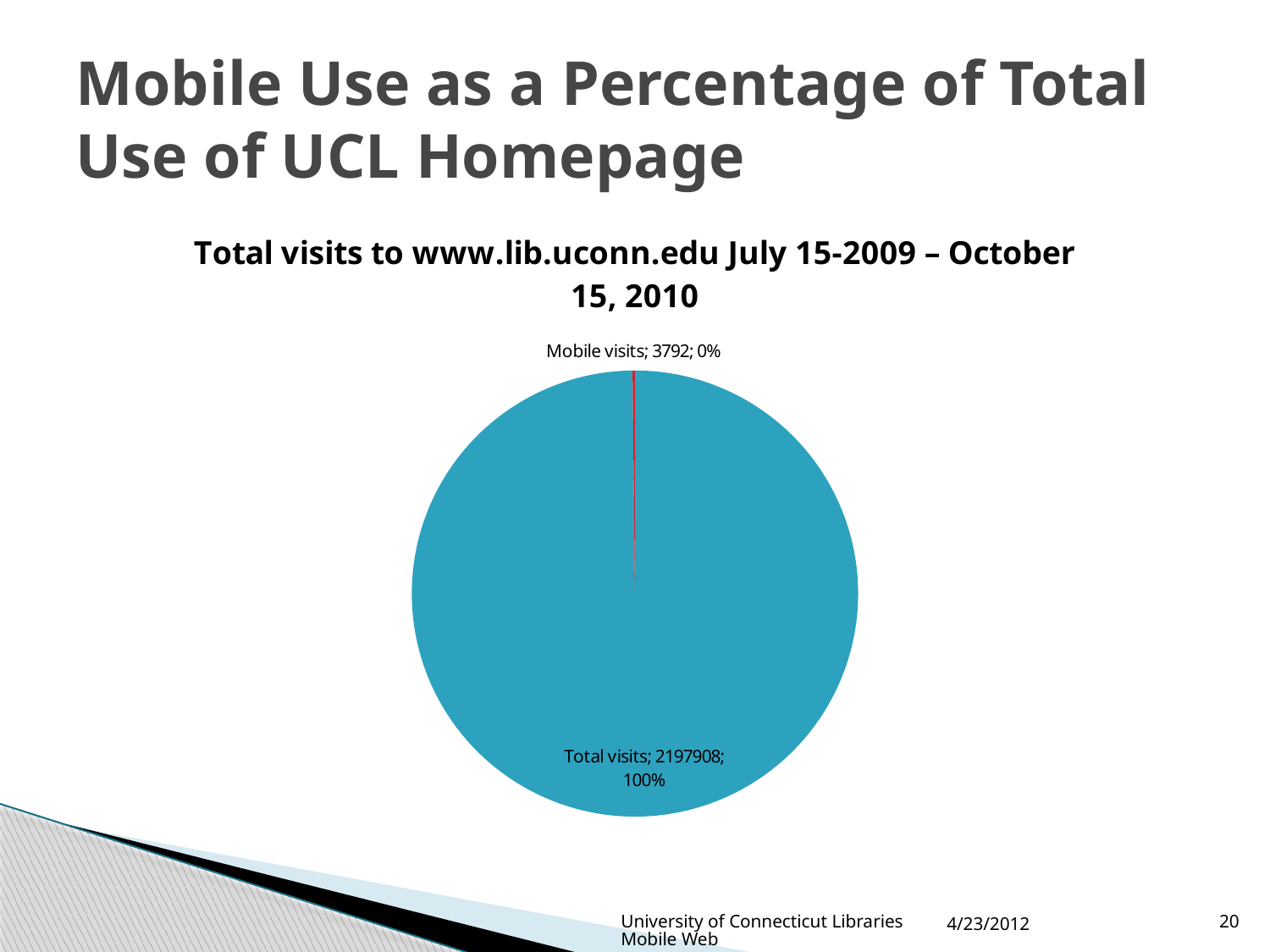
What is the value for Mobile visits? 3792 Which slice is the largest in the pie chart? Total visits What colour is the Total visits slice? Blue What is the difference between Total visits and Mobile visits? 2194116 How many slices does the pie chart have? 2 What is the value for Total visits? 2197908 What kind of chart is shown on the slide? Pie chart Which is larger, Mobile visits or Total visits? Total visits What percentage share is shown for the Mobile visits slice? 0% Which slice is the smallest in the pie chart? Mobile visits What is the title of the pie chart? Total visits to www.lib.uconn.edu July 15-2009 – October 15, 2010 What percentage share is shown for the Total visits slice? 100%